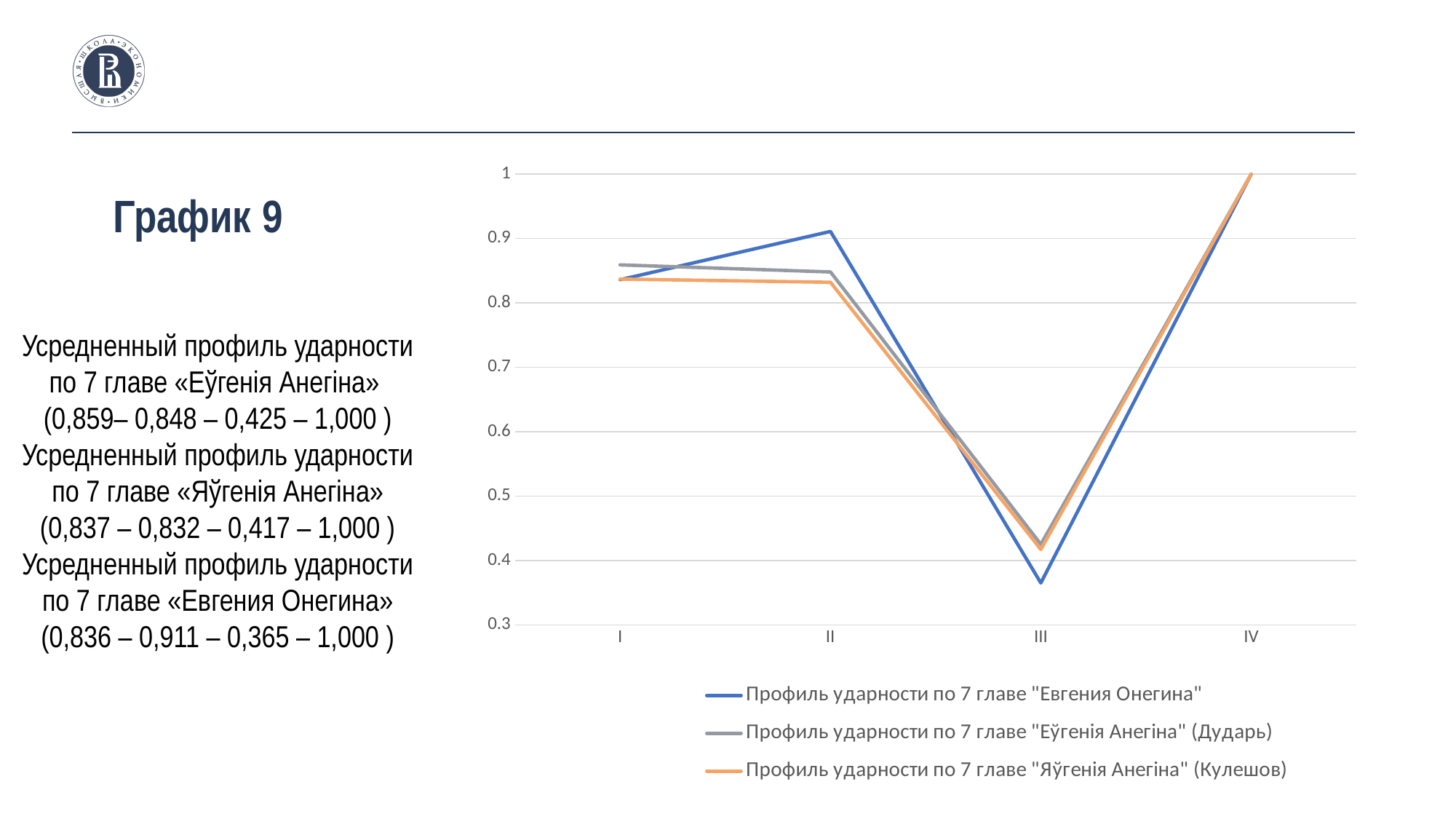
Do the values of all three series rise or fall from point II to point III? fall At point II, which is larger: the value for "Евгения Онегина" or the value for "Еўгенія Анегіна" (Дударь)? Евгения Онегина Is the value for "Евгения Онегина" at point III greater or less than 0.4? less According to the slide text, what is the value at point I for the profile of "Яўгенія Анегіна" (Кулешов)? 0,837 According to the slide text, what is the value at point II for the profile of "Евгения Онегина"? 0,911 According to the slide text, what is the value at point III for the profile of "Еўгенія Анегіна" (Дударь)? 0,425 What is the difference between the values at point II and point III for the profile of "Евгения Онегина" (0,911 and 0,365)? 0,546 What kind of chart is shown on the slide? line chart At which point do all three series reach their highest value? IV How many series does the legend list? 3 At which point does the profile of "Евгения Онегина" reach its lowest value? III How many points are plotted along the x axis for each series? 4